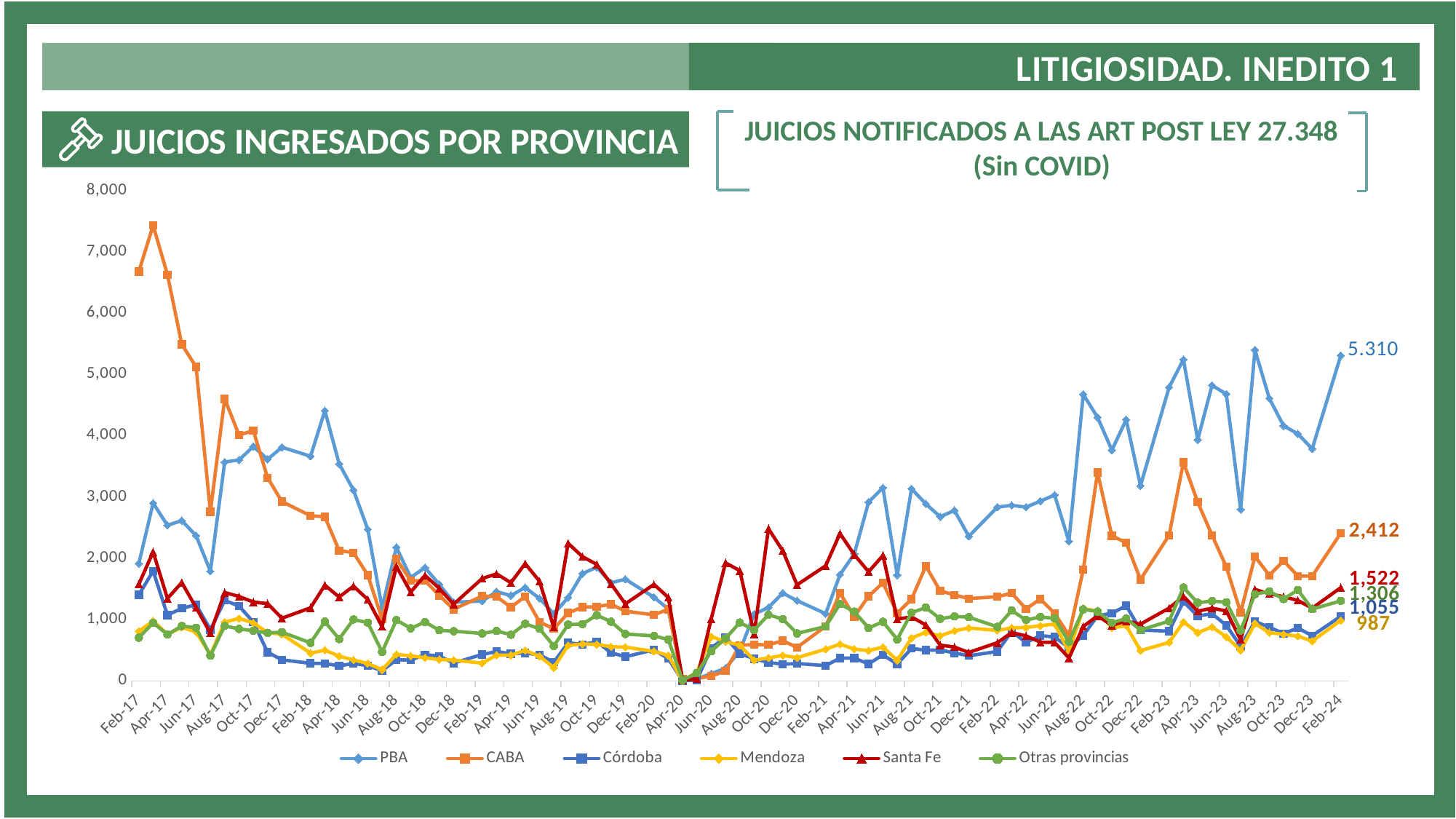
Is the value for CABA at Feb-17 greater or less than 6,000? greater What is the value labelled for CABA at Feb-24? 2,412 What is the value labelled for Mendoza at Feb-24? 987 Does the CABA series rise or fall from Feb-17 to Aug-17? fall What is the difference between the Córdoba and Mendoza values at Feb-24? 68 At Feb-24, which is larger, Santa Fe or Otras provincias? Santa Fe What is the value labelled for Santa Fe at Feb-24? 1,522 How many series does the legend list? 6 Which series has the lowest value at Feb-24? Mendoza Which series has the highest value at Feb-24? PBA What kind of chart is shown on the slide? line chart What is the value labelled for PBA at Feb-24? 5.310